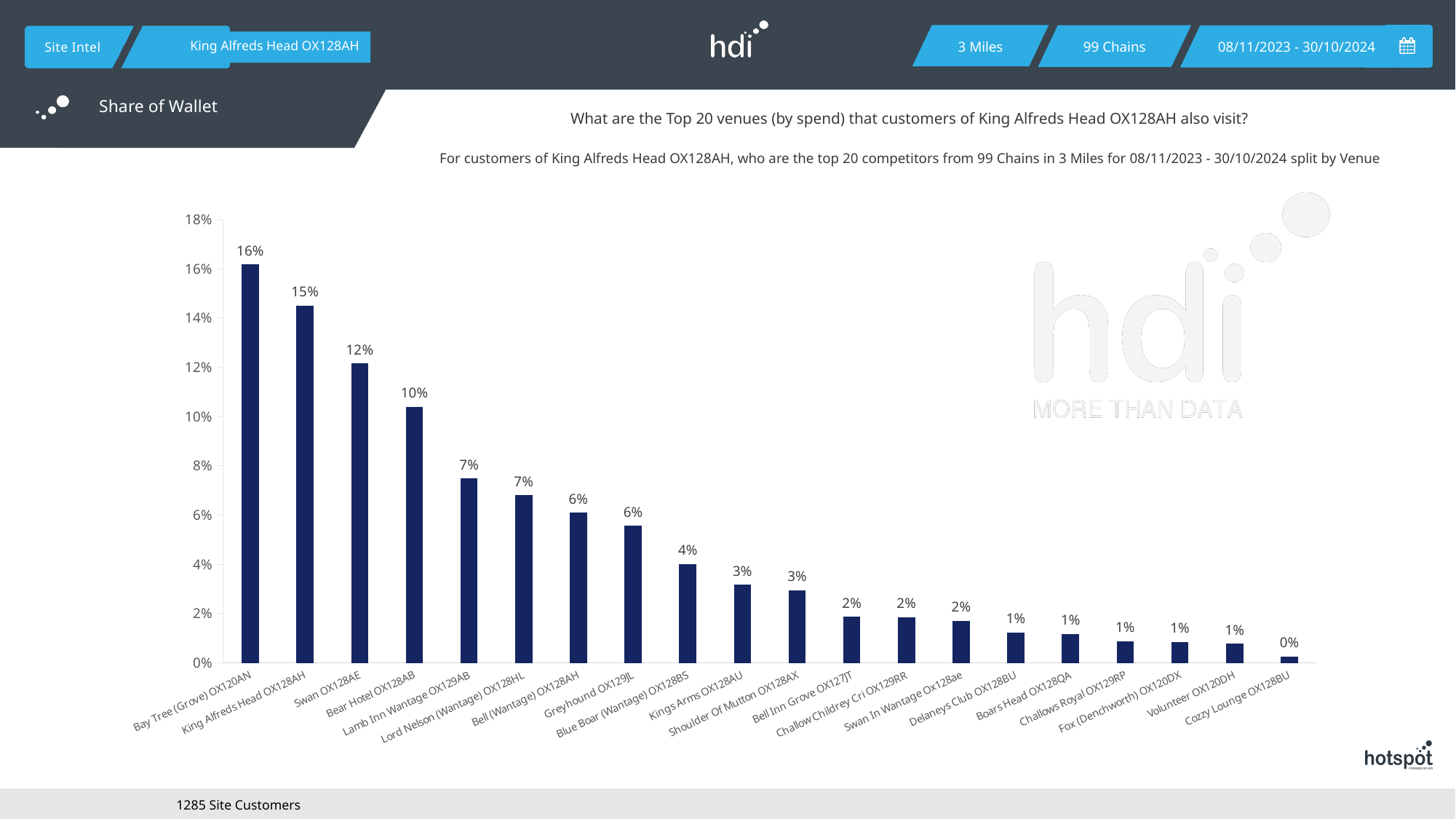
What kind of chart is shown on the slide? Bar chart Which venue has the lowest value? Cozzy Lounge OX128BU Is the value for Bear Hotel OX128AB greater or less than 8%? greater What is the difference between the values for Bay Tree (Grove) OX120AN and Bear Hotel OX128AB? 6% What is the value for Blue Boar (Wantage) OX128BS? 4% What is the value for Bell Inn Grove OX127JT? 2% Which is larger, the value for Swan OX128AE or the value for Kings Arms OX128AU? Swan OX128AE What is the value for Bay Tree (Grove) OX120AN? 16% How many venues are shown on the chart? 20 What is the value for Swan OX128AE? 12% Which venue has the highest value? Bay Tree (Grove) OX120AN Do the values rise or fall from left to right along the x axis? Fall